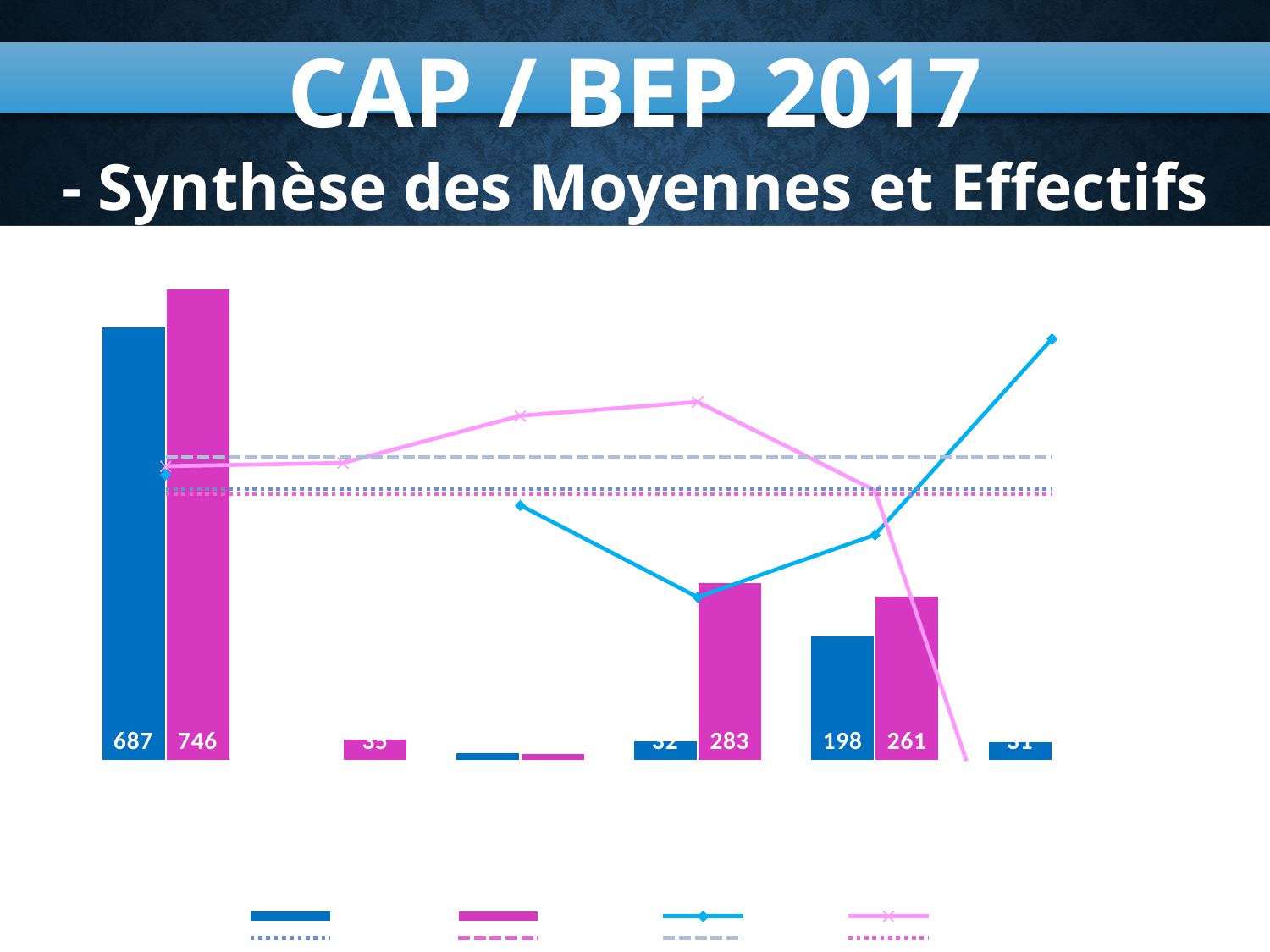
How many groups of bars (categories) are plotted along the x axis? 6 What kind of chart is shown on the slide? A combined bar and line chart What is the difference between the magenta bar (261) and the blue bar (198) in the fifth group? 63 Which bar is the tallest on the chart? The magenta bar in the first group (746) What is the value of the magenta bar in the fourth group of bars from the left? 283 Does the pink line with x markers rise or fall between its last two points? Fall Which is larger, the magenta bar labelled 283 or the magenta bar labelled 261? 283 What is the difference between the two bars in the leftmost group (746 and 687)? 59 What is the value of the leftmost magenta bar? 746 What is the value of the blue bar in the fifth group of bars from the left? 198 What is the value of the magenta bar in the fifth group of bars from the left? 261 What is the value of the leftmost blue bar? 687